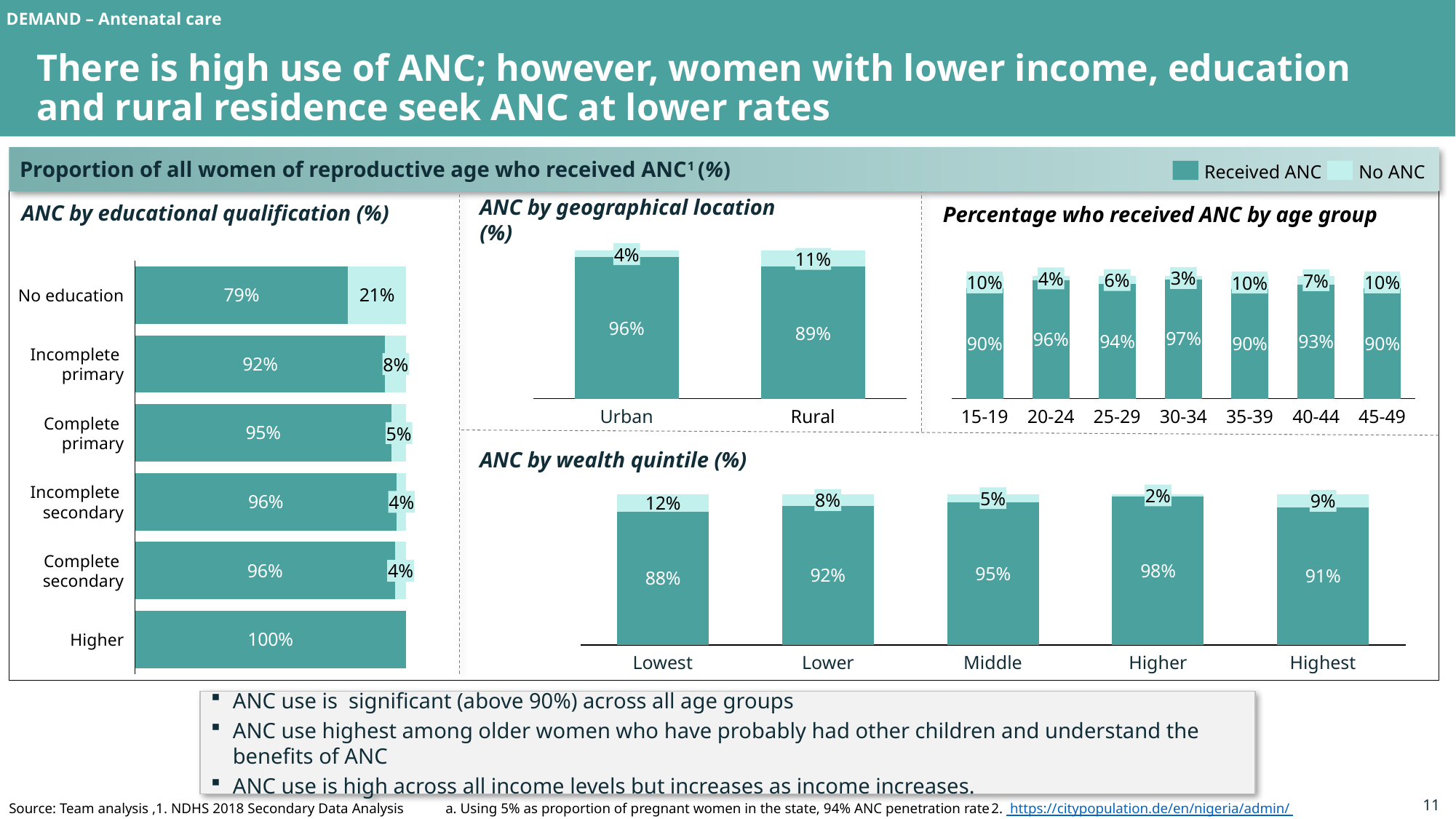
In the 'Percentage who received ANC by age group' chart, what is the Received ANC value for the 40-44 age group? 93% In the 'ANC by geographical location (%)' chart, which location has the higher Received ANC value, Urban or Rural? Urban In the 'Percentage who received ANC by age group' chart, how many age groups are shown? 7 In the 'ANC by educational qualification (%)' chart, what is the difference between the Received ANC values for Higher and No education? 21 percentage points In the 'ANC by educational qualification (%)' chart, which educational category has the lowest share of women who received ANC? No education How many series does the legend at the top of the slide list? 2 In the 'Percentage who received ANC by age group' chart, which age group has the highest Received ANC value? 30-34 In the 'ANC by wealth quintile (%)' chart, what is the difference between the No ANC values for the Lowest and Highest quintiles? 3 percentage points In the 'ANC by wealth quintile (%)' chart, which wealth quintile has the highest Received ANC value? Higher In the 'ANC by educational qualification (%)' chart, what percentage of women with no education received ANC? 79% In the 'ANC by geographical location (%)' chart, what percentage of rural women did not receive ANC? 11% In the 'ANC by educational qualification (%)' chart, how many educational categories are shown? 6